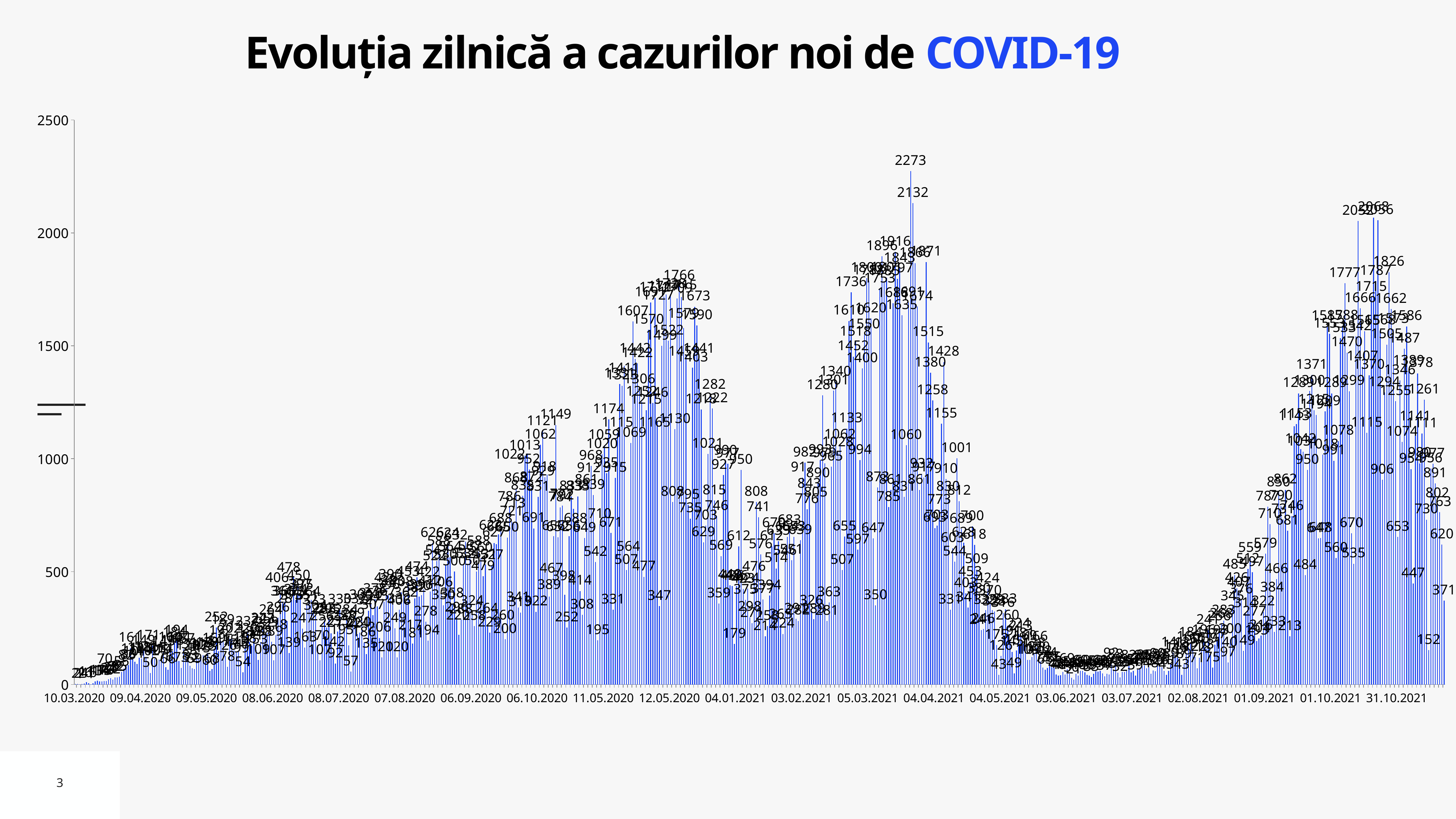
What is the highest daily value labelled on the chart? 2273 What kind of chart is shown on the slide? bar chart Is the value for 03.06.2021 greater or less than 500? less Do the values rise or fall between 04.04.2021 and 03.06.2021? fall What is the difference between the two highest labelled values, 2273 and 2132? 141 What is the second-highest value labelled near the peak around 04.04.2021? 2132 What is the title of the chart? Evoluția zilnică a cazurilor noi de COVID-19 What is the maximum value shown on the vertical axis? 2500 What is the first date label on the horizontal axis? 10.03.2020 Which is larger: the peak value of 2273 (around 04.04.2021) or the peak value of 1766 (around 12.05.2020)? 2273 Is the highest value on the chart greater or less than 2000? greater Do the values rise or fall between 02.08.2021 and 01.10.2021? rise